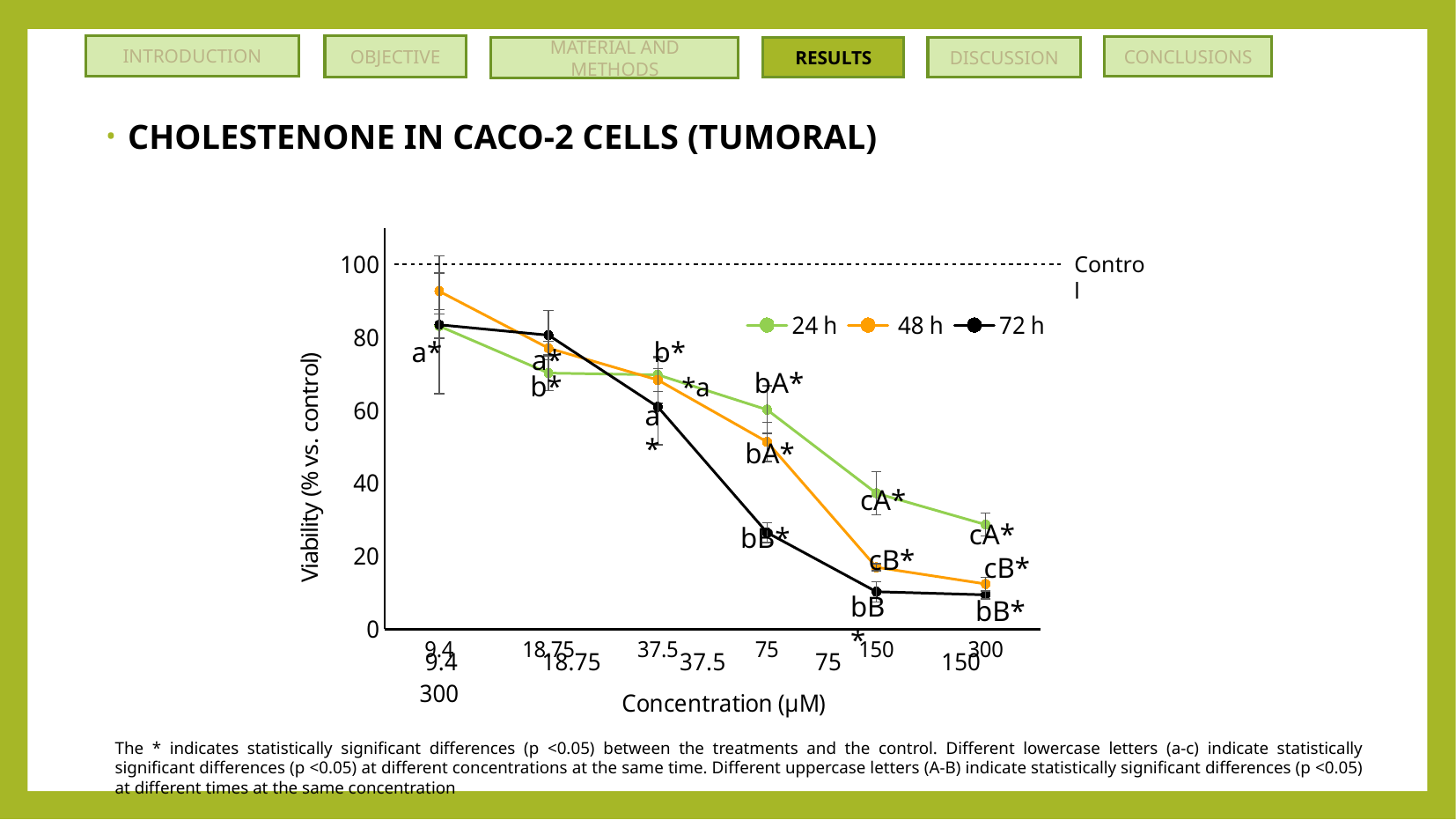
Which series has the highest viability at 300 µM? 24 h How many concentration points are plotted along the x axis? 6 Is the 48 h viability at 75 µM greater or less than 60? less What is the label of the y axis? Viability (% vs. control) Is the 48 h viability at 9.4 µM greater or less than 80? greater At 150 µM, which series has the higher viability, 24 h or 72 h? 24 h How many series does the legend list? 3 Is the 24 h viability at 300 µM greater or less than 20? greater Which series has the lowest viability at 75 µM? 72 h Does viability rise or fall as concentration increases along the x axis? Fall What kind of chart is shown on the slide? Line chart